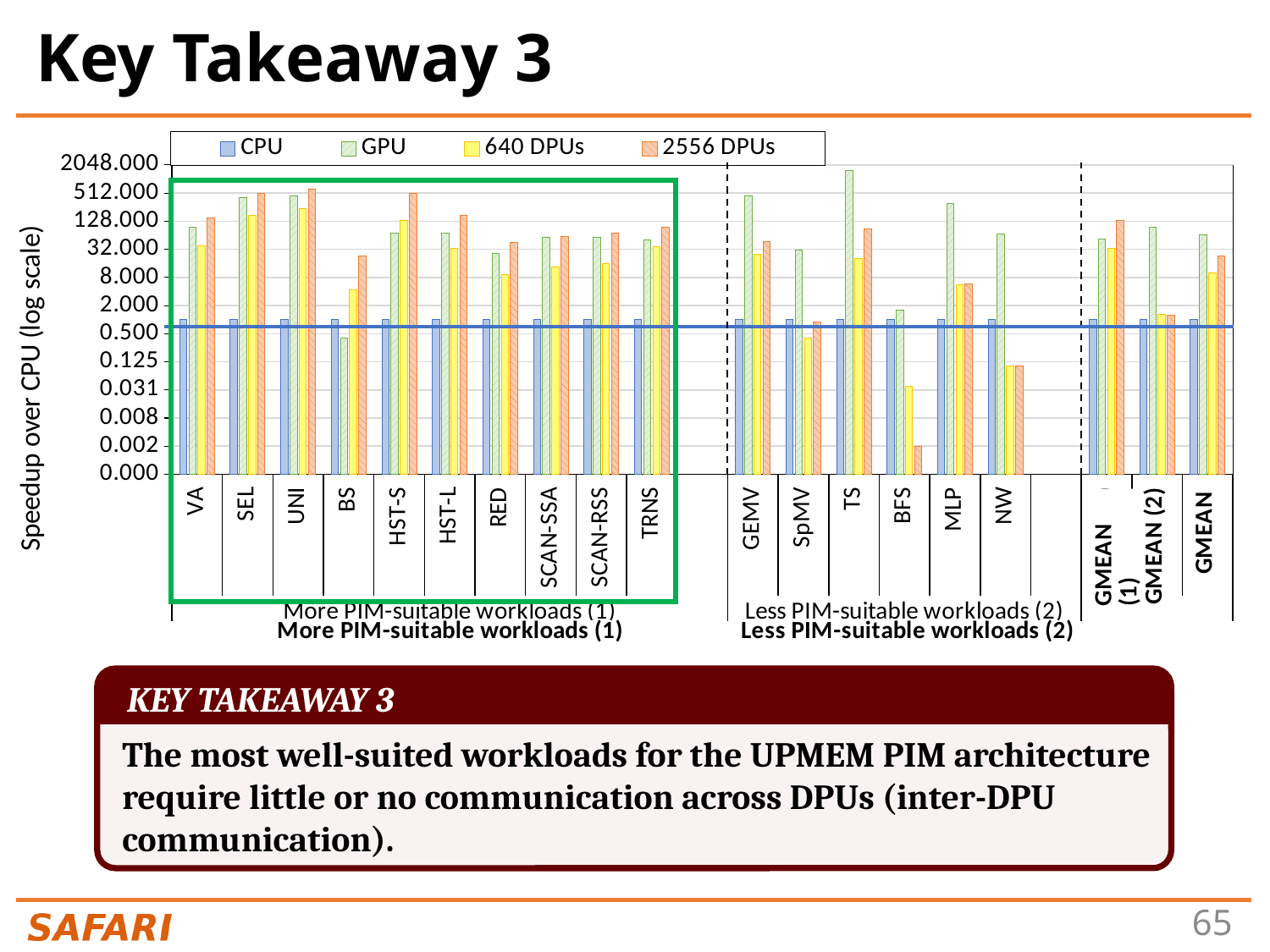
How many series does the chart legend list? 4 What is the label of the y-axis? Speedup over CPU (log scale) Is the 2556 DPUs value for BFS greater or less than 0.008? less Is the GPU value for GEMV greater or less than 128.000? greater Which workload has the highest GPU bar? TS For BS, which is larger: the GPU value or the 2556 DPUs value? 2556 DPUs What kind of chart is shown on the slide? bar chart How many workloads are in the 'Less PIM-suitable workloads (2)' group? 6 For TS, which is larger: the GPU value or the 2556 DPUs value? GPU Is the 640 DPUs value for NW greater or less than 0.500? less How many workloads are in the 'More PIM-suitable workloads (1)' group? 10